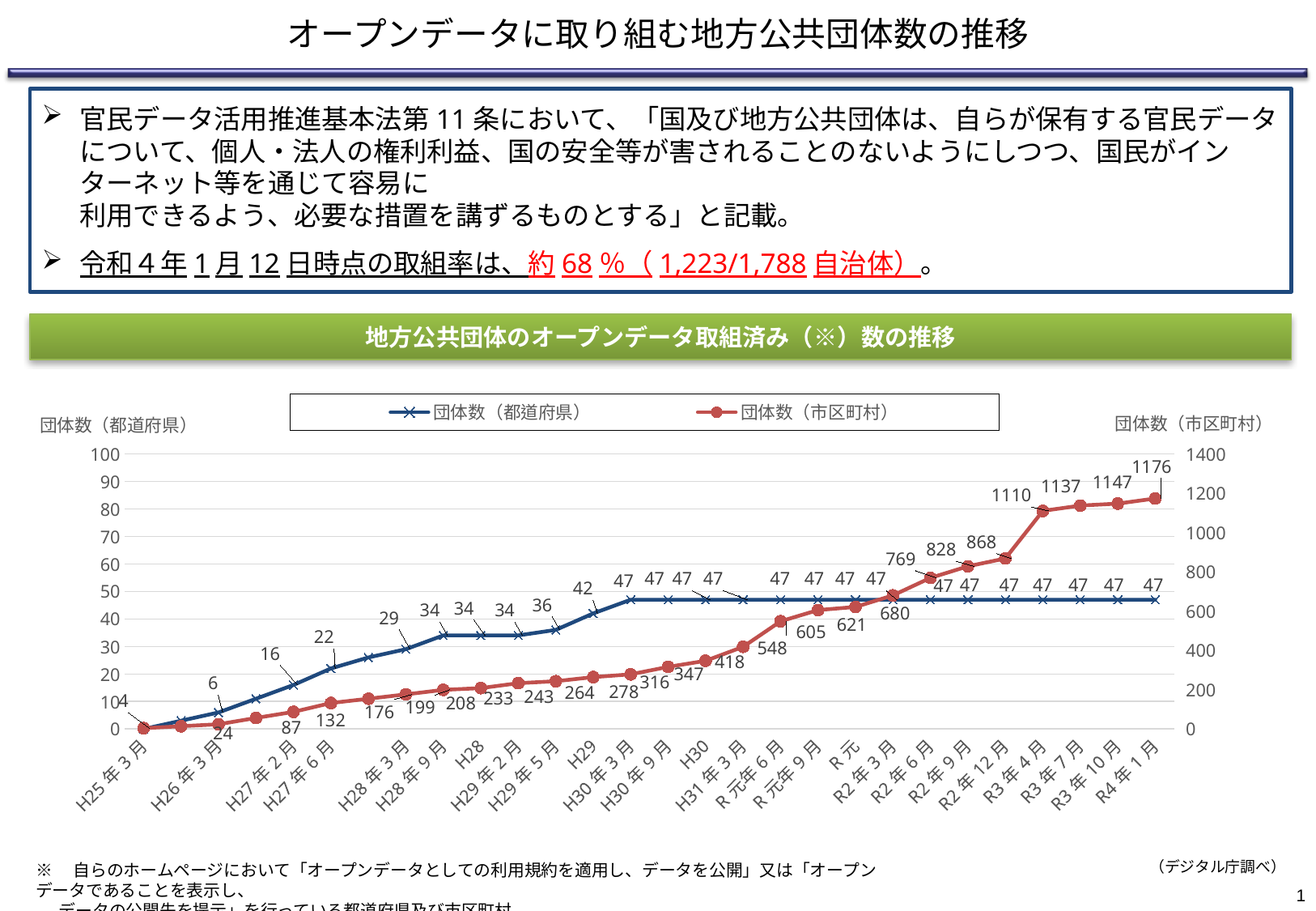
What is the value of 団体数（市区町村） at R2年12月? 868 What is the maximum value shown on the right-hand axis (団体数（市区町村）)? 1400 What type of chart is shown on the slide? line chart Is the value of 団体数（都道府県） at H25年3月 greater or less than 10? less Does 団体数（市区町村） generally rise or fall along the x axis? rise How many series does the legend list? 2 What is the difference between 団体数（市区町村） at R4年1月 and at R3年10月? 29 At which x-axis point is 団体数（市区町村） highest? R4年1月 Which is larger: 団体数（市区町村） at R3年4月 or at R2年12月? R3年4月 What is the value of 団体数（市区町村） at R3年4月? 1110 What is the value of 団体数（都道府県） at R4年1月? 47 What is the value of 団体数（市区町村） at R4年1月? 1176